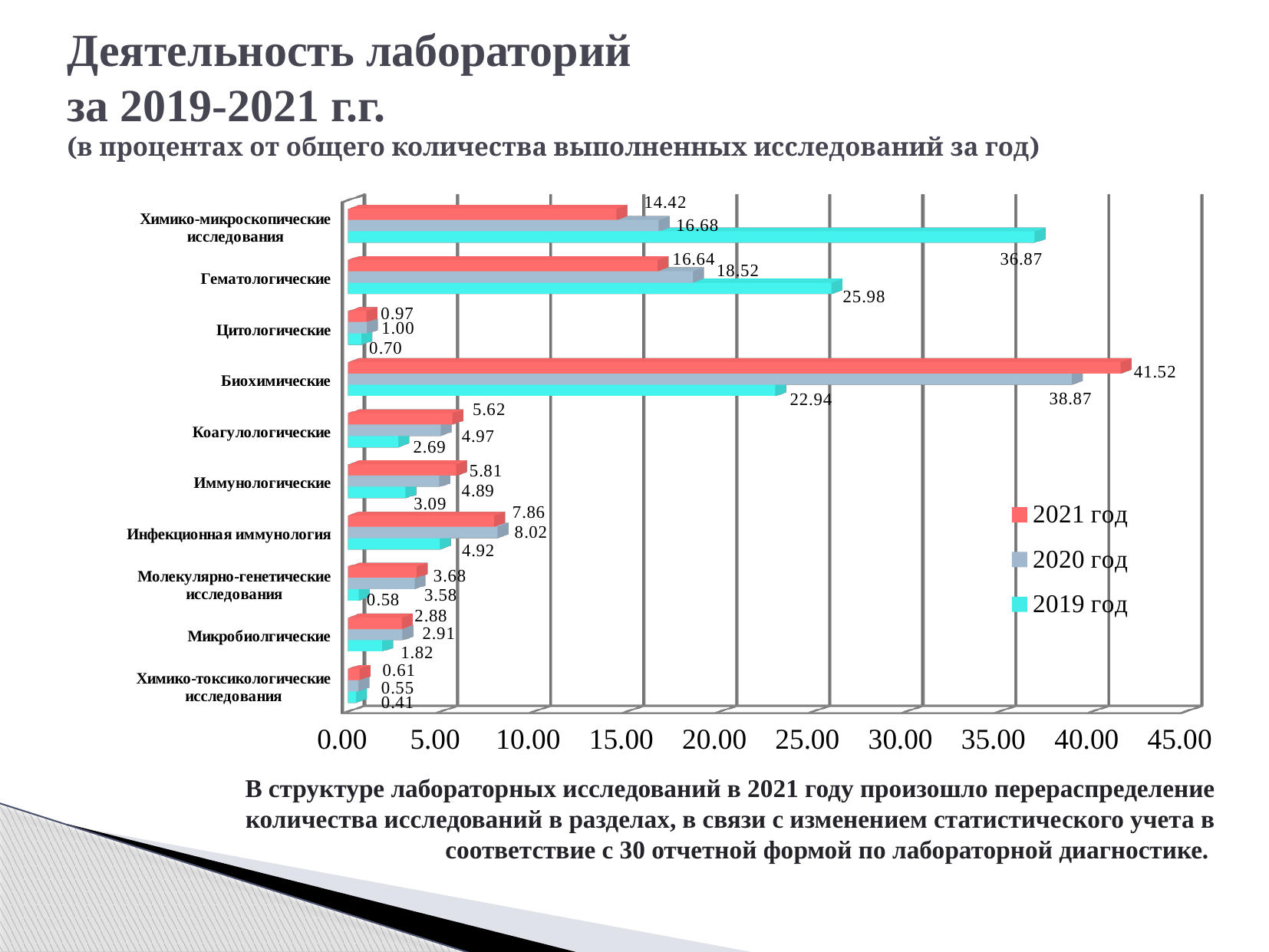
How many categories are shown on the chart? 10 What is the value for Биохимические in the 2021 год series? 41.52 How many series does the legend list? 3 What is the value for Химико-микроскопические исследования in the 2019 год series? 36.87 What is the difference between the 2019 год and 2021 год values for Химико-микроскопические исследования? 22.45 What kind of chart is shown on the slide? Bar chart Which is larger for Инфекционная иммунология: the 2021 год value or the 2020 год value? 2020 год Which category has the lowest value in the 2019 год series? Химико-токсикологические исследования What is the difference between the 2021 год and 2019 год values for Биохимические? 18.58 What is the value for Гематологические in the 2020 год series? 18.52 Which colour represents the 2019 год series in the legend? Cyan (turquoise) Which category has the highest value in the 2021 год series? Биохимические